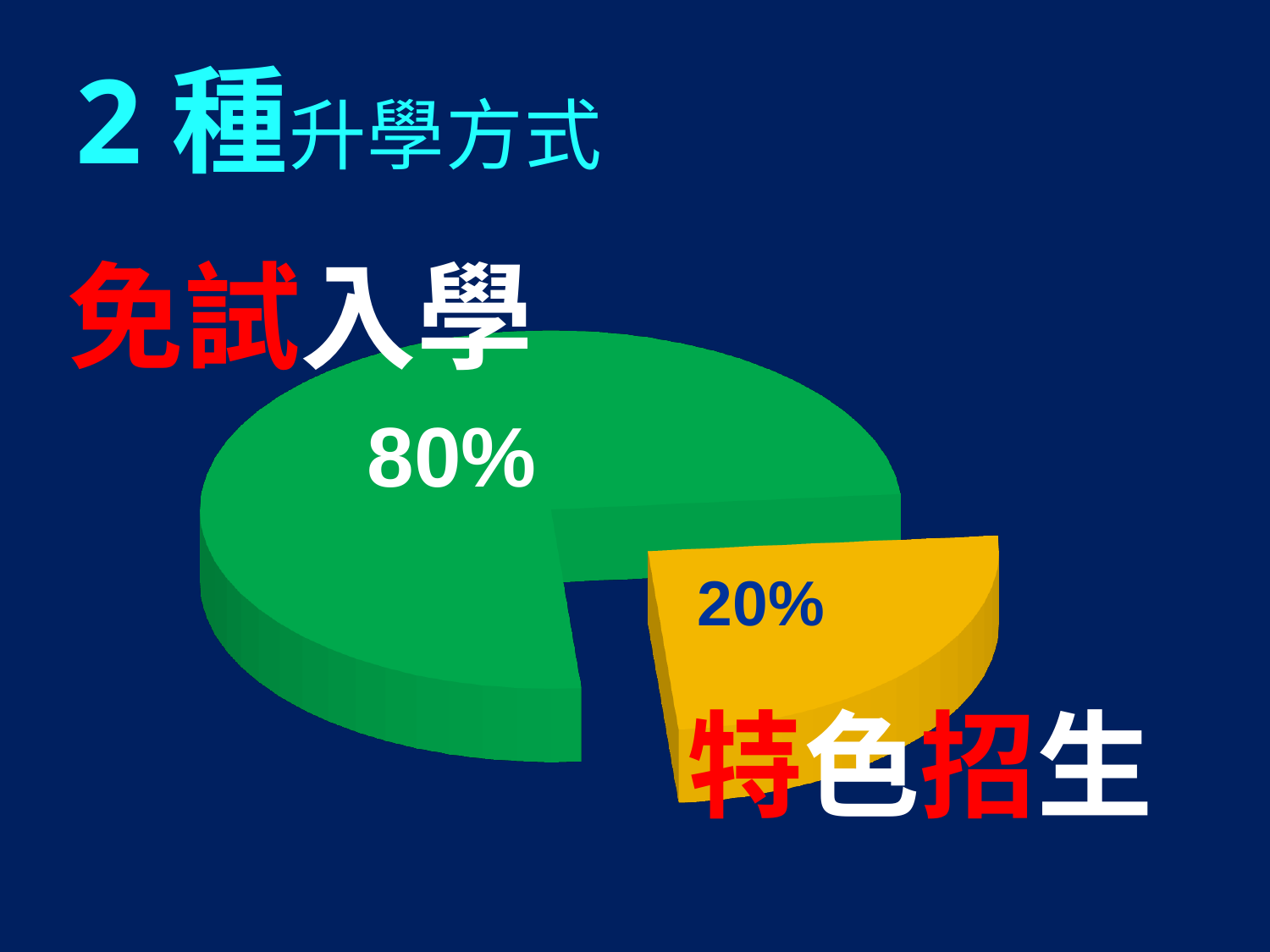
Which category has the largest slice of the pie? 免試入學 What colour is the slice for 特色招生? yellow How many slices does the pie chart have? 2 What share of the pie does 免試入學 represent? 80% What is the total of the two slices shown in the pie chart? 100% Which category has the smallest slice of the pie? 特色招生 What share of the pie does 特色招生 represent? 20% Which is larger, the slice for 免試入學 or the slice for 特色招生? 免試入學 What is the difference in percentage points between 免試入學 and 特色招生? 60% What colour is the slice for 免試入學? green What kind of chart is shown on the slide? pie chart